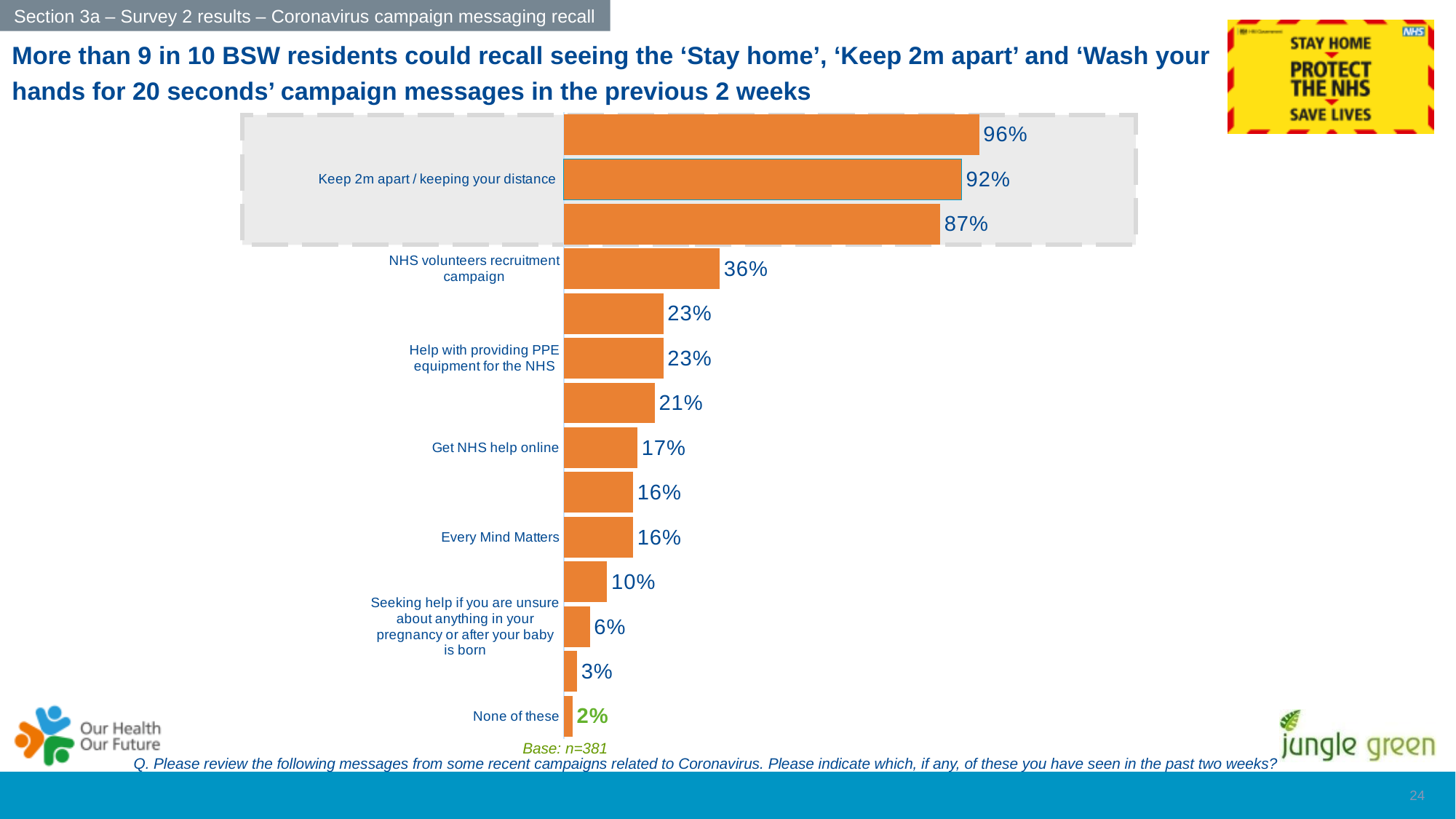
What is the value for 'Help with providing PPE equipment for the NHS'? 23% What is the value shown for the 'NHS volunteers recruitment campaign' bar? 36% How many bars are plotted on the chart? 14 What is the difference between the values for 'Keep 2m apart / keeping your distance' and 'NHS volunteers recruitment campaign'? 56 percentage points What is the value for 'Every Mind Matters'? 16% What is the value for 'None of these'? 2% What percentage of respondents recalled seeing the 'Keep 2m apart / keeping your distance' message? 92% What is the highest value shown on the chart? 96% Which is larger: the value for 'Get NHS help online' or the value for 'Every Mind Matters'? Get NHS help online What is the value for 'Get NHS help online'? 17% Which category has the lowest value on the chart? None of these What type of chart is shown on the slide? Bar chart